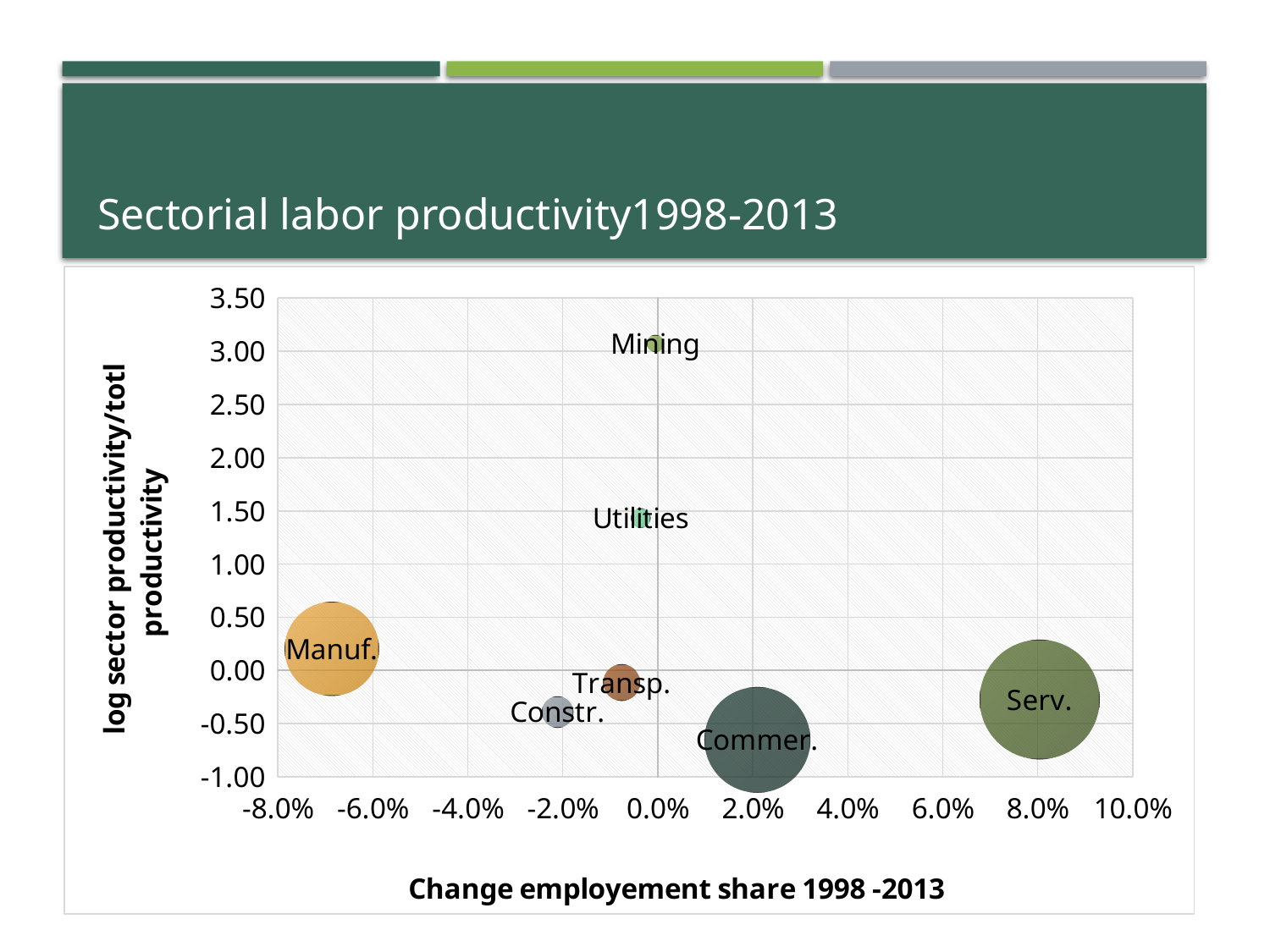
How many sectors (bubbles) are plotted on the chart? 7 Which sector has the largest change in employment share 1998-2013? Serv. Is the change in employment share for Serv. greater or less than 6.0%? greater Is the log productivity value for Utilities greater or less than 2.00? less Which has the higher log sector productivity, Mining or Utilities? Mining Which sector has the lowest log sector productivity/total productivity? Commer. What kind of chart is shown on the slide? bubble chart What is the label of the x axis? Change employement share 1998 -2013 Is the change in employment share for Manuf. greater or less than -4.0%? less Which sector has the most negative change in employment share 1998-2013? Manuf. Which sector has the highest log sector productivity/total productivity? Mining